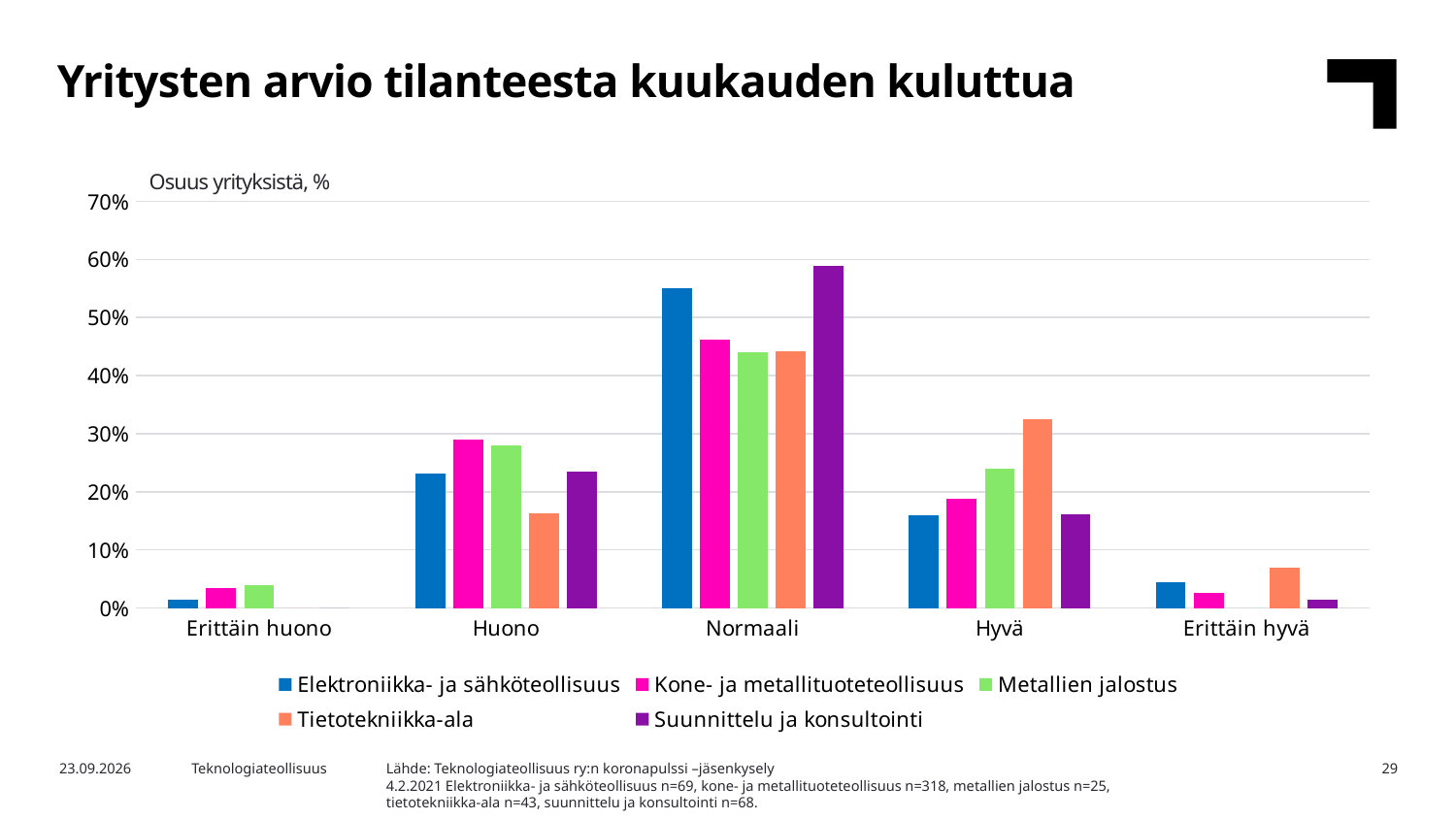
Is the value for Elektroniikka- ja sähköteollisuus in the Huono category greater or less than 20%? greater In the Normaali category, which series has the highest value? Suunnittelu ja konsultointi In the Huono category, which series has the lowest value? Tietotekniikka-ala In the Hyvä category, which is larger: Tietotekniikka-ala or Metallien jalostus? Tietotekniikka-ala How many categories are shown on the x axis? 5 Is the value for Tietotekniikka-ala in the Hyvä category greater or less than 30%? greater For Elektroniikka- ja sähköteollisuus, which category has the highest value? Normaali What kind of chart is shown on the slide? bar chart Is the value for Suunnittelu ja konsultointi in the Normaali category greater or less than 50%? greater What is the label shown above the vertical axis of the chart? Osuus yrityksistä, % How many series does the legend list? 5